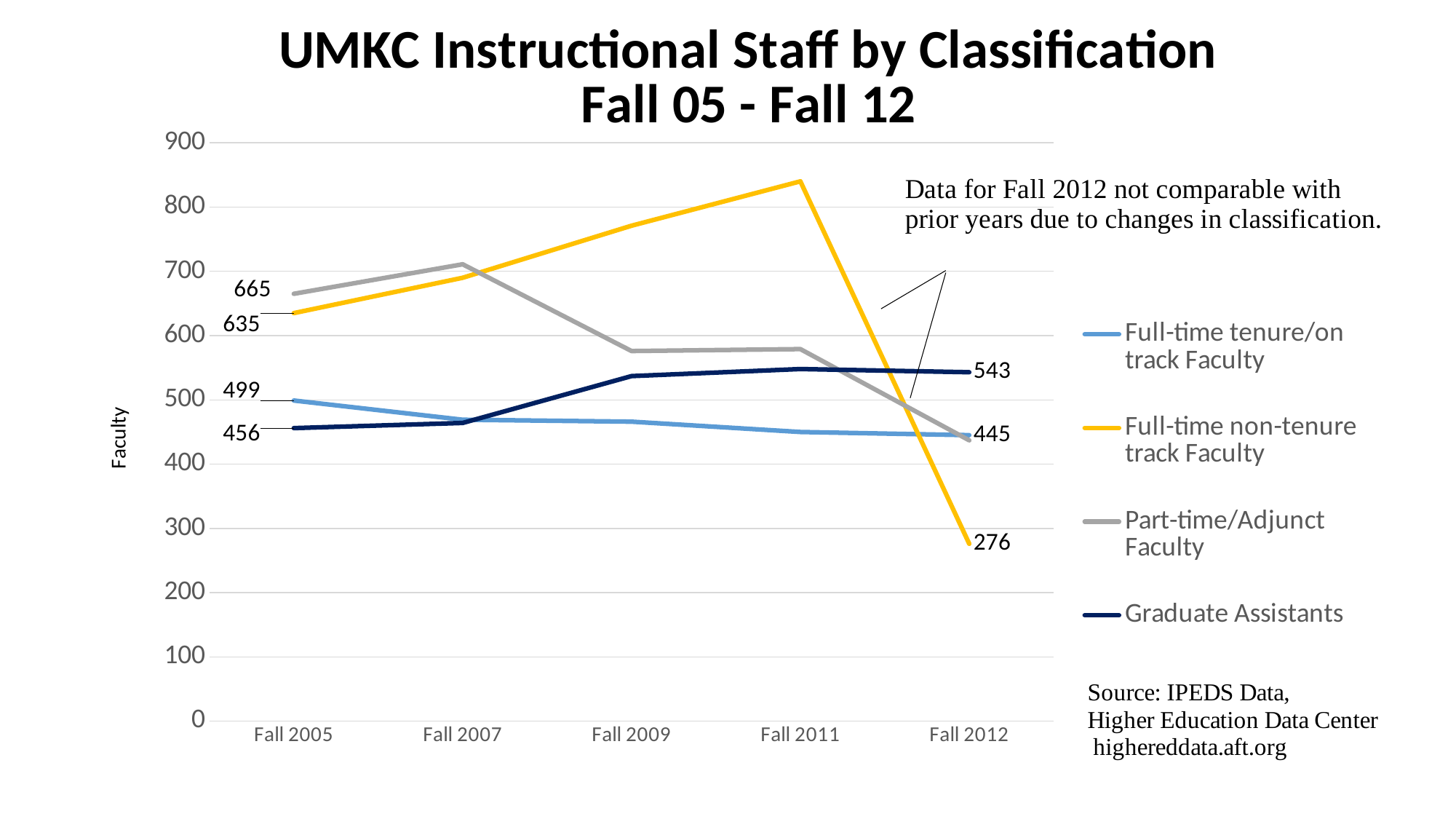
Which series has the highest value in Fall 2005? Part-time/Adjunct Faculty Is the value for Full-time non-tenure track Faculty in Fall 2011 greater or less than 800? greater What is the value for Full-time non-tenure track Faculty in Fall 2005? 635 What is the value for Full-time tenure/on track Faculty in Fall 2005? 499 What is the value for Full-time non-tenure track Faculty in Fall 2012? 276 What is the value for Part-time/Adjunct Faculty in Fall 2005? 665 What is the value for Graduate Assistants in Fall 2012? 543 By how much did Graduate Assistants increase from Fall 2005 (456) to Fall 2012 (543)? 87 What kind of chart is shown on the slide? Line chart Does the Full-time tenure/on track Faculty line rise or fall from Fall 2005 to Fall 2012? Fall How many time points are shown on the x axis? 5 How many series does the legend list? 4